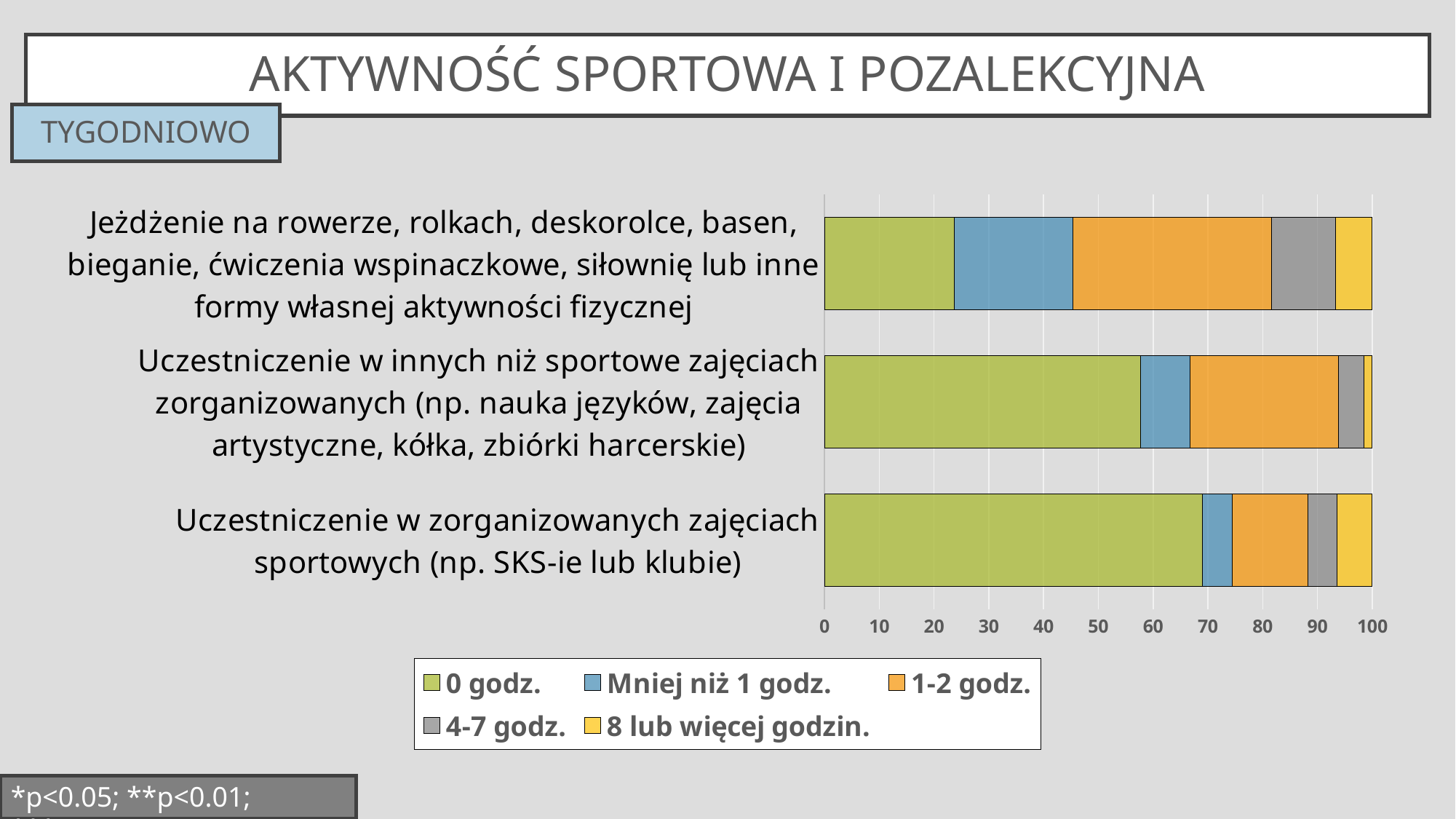
Is the "0 godz." value for "Uczestniczenie w innych niż sportowe zajęciach zorganizowanych" greater or less than 50? greater What kind of chart is shown on the slide? Stacked bar chart Which category has the largest "0 godz." segment? Uczestniczenie w zorganizowanych zajęciach sportowych (np. SKS-ie lub klubie) Is the "0 godz." value for "Jeżdżenie na rowerze, rolkach, deskorolce, basen, bieganie, ćwiczenia wspinaczkowe, siłownię lub inne formy własnej aktywności fizycznej" greater or less than 30? less Which has a larger "Mniej niż 1 godz." segment: "Jeżdżenie na rowerze..." or "Uczestniczenie w zorganizowanych zajęciach sportowych"? Jeżdżenie na rowerze, rolkach, deskorolce, basen, bieganie, ćwiczenia wspinaczkowe, siłownię lub inne formy własnej aktywności fizycznej Is the "0 godz." value for "Uczestniczenie w zorganizowanych zajęciach sportowych (np. SKS-ie lub klubie)" greater or less than 60? greater How many categories (activity types) are plotted on the chart? 3 Which category has the largest "1-2 godz." segment? Jeżdżenie na rowerze, rolkach, deskorolce, basen, bieganie, ćwiczenia wspinaczkowe, siłownię lub inne formy własnej aktywności fizycznej Which legend entry is shown in yellow? 8 lub więcej godzin. How many series does the chart legend list? 5 What is the maximum value shown on the horizontal axis of the chart? 100 Which category has the smallest "0 godz." segment? Jeżdżenie na rowerze, rolkach, deskorolce, basen, bieganie, ćwiczenia wspinaczkowe, siłownię lub inne formy własnej aktywności fizycznej